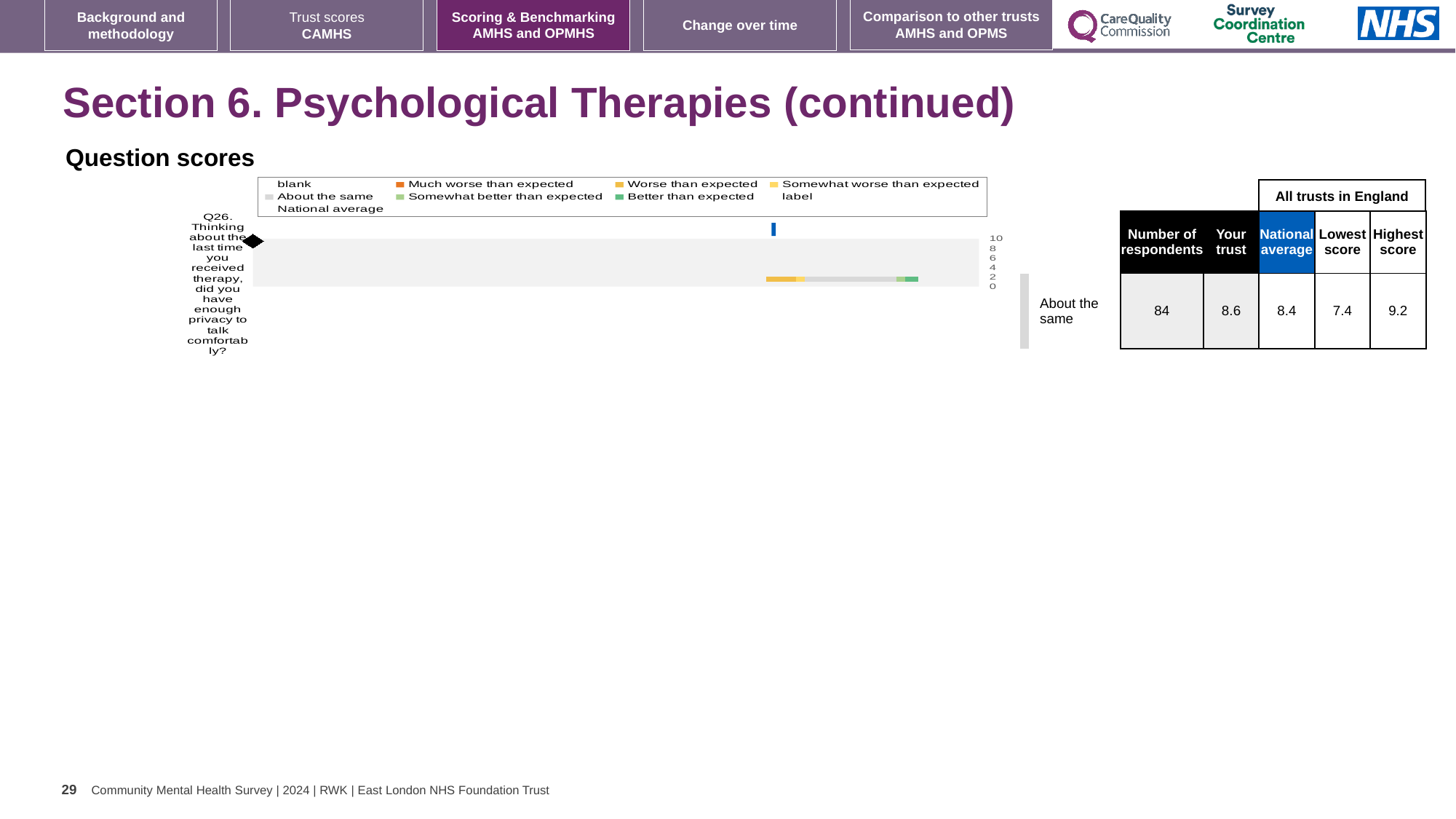
Is the trust's score marker for Q26 greater or less than 6 on the chart axis? greater How many questions are plotted on the chart? 1 Which is larger for Q26, the trust's score or the national average? the trust's score According to the table beside the chart, what is the national average for Q26? 8.4 According to the table beside the chart, how many respondents answered Q26? 84 According to the table beside the chart, what is the trust's score for Q26? 8.6 According to the table beside the chart, what is the highest score among all trusts in England for Q26? 9.2 What is the difference between the highest score and the lowest score for Q26 in the table beside the chart? 1.8 Which question is plotted on the chart? Q26. Thinking about the last time you received therapy, did you have enough privacy to talk comfortably? According to the table beside the chart, what is the lowest score among all trusts in England for Q26? 7.4 What is the highest value shown on the chart's axis? 10 What kind of chart is used to show the Q26 question score? bar chart